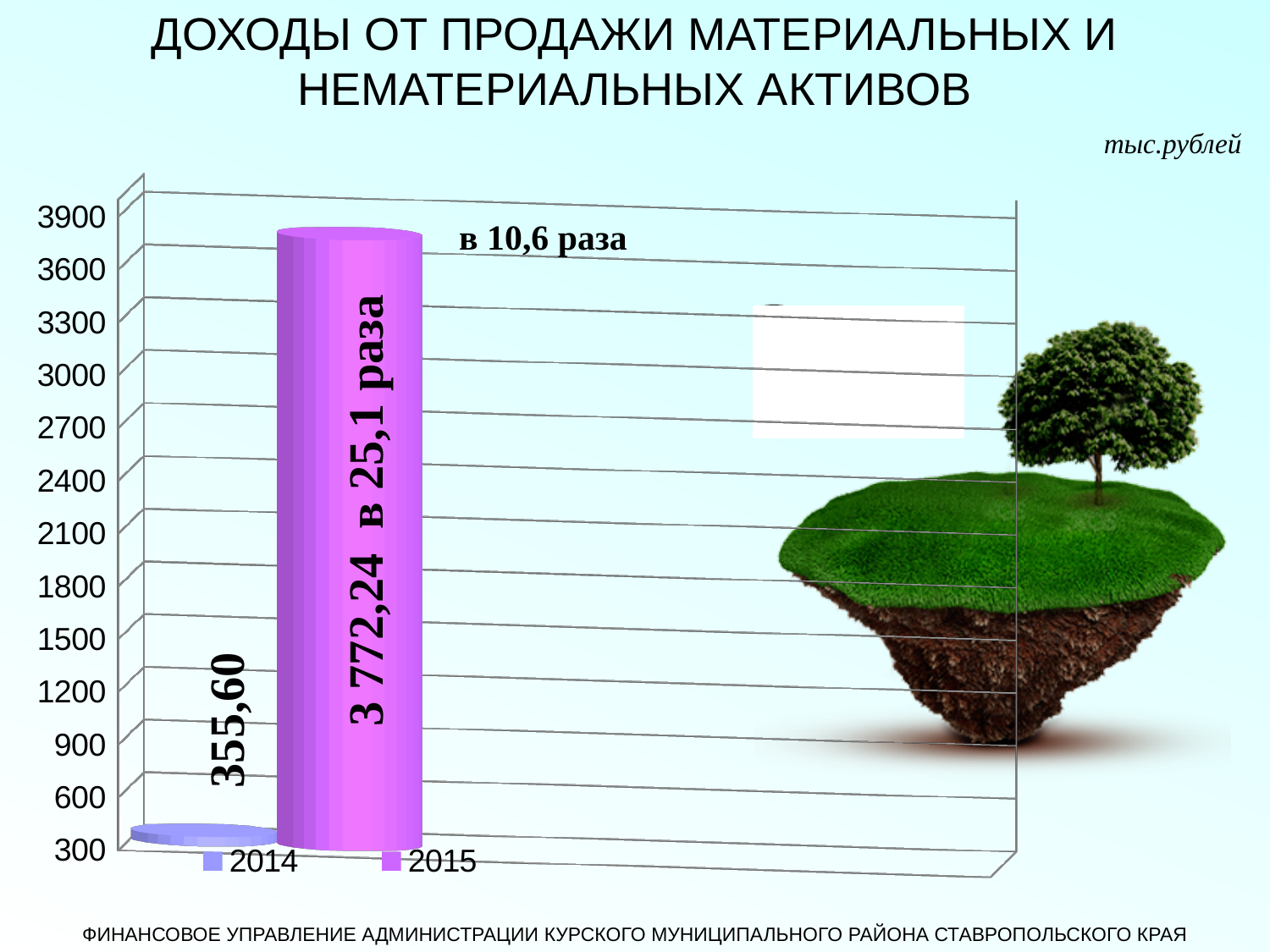
How many bars are plotted on the chart? 2 How many entries does the legend list? 2 Which year has the lower value? 2014 What is the difference between the 2015 and 2014 values? 3 416,64 Which year has the higher value? 2015 What is the value for 2015? 3 772,24 Is the value for 2014 greater or less than 600? less Is the value for 2015 greater or less than 3600? greater What kind of chart is shown on the slide? bar chart What unit of measurement is indicated for the chart? тыс.рублей Do the values rise or fall from 2014 to 2015? rise What is the value for 2014? 355,60